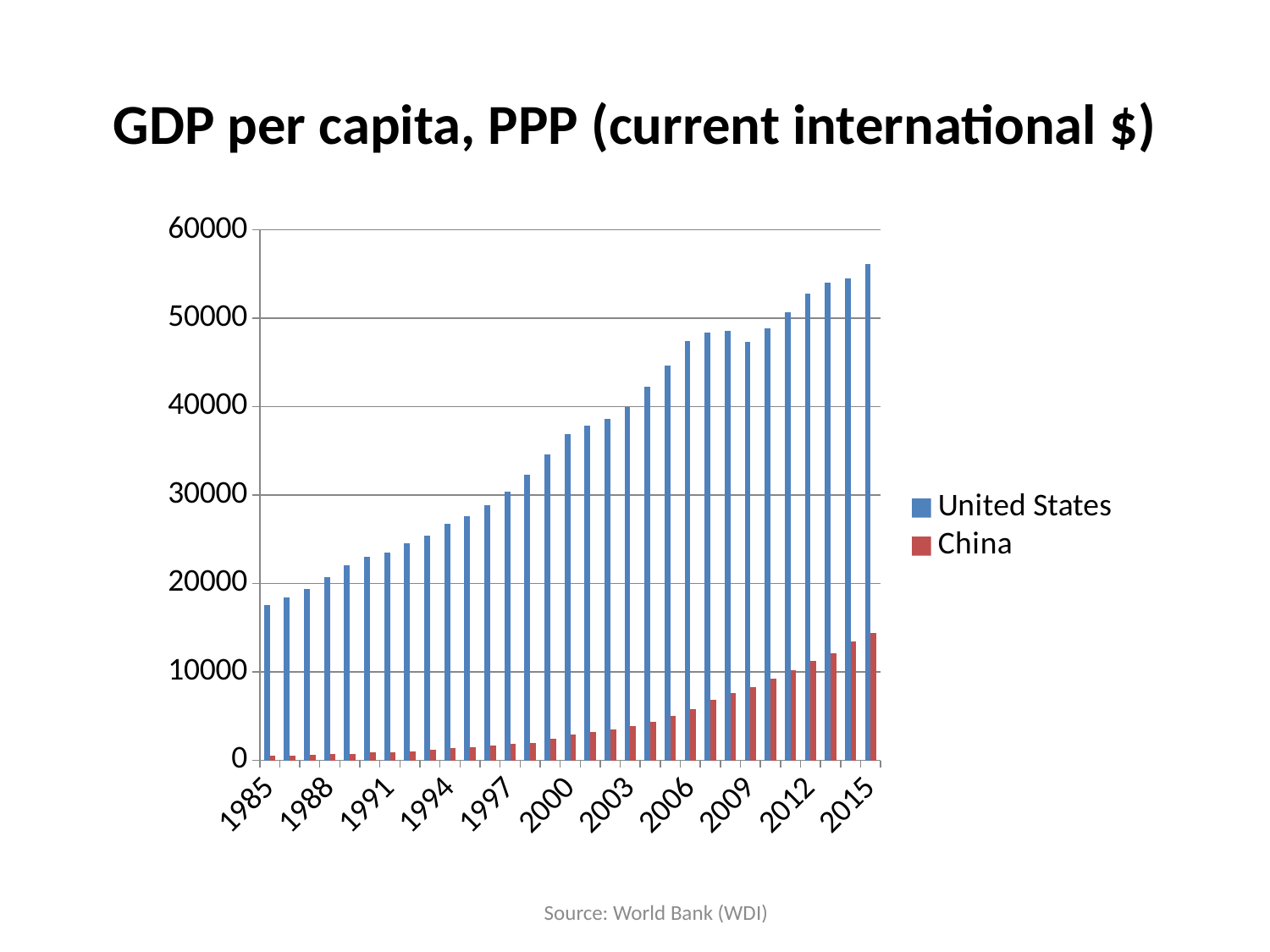
Is the value for the United States in 1985 greater or less than 20000? less In which year is the United States value lowest? 1985 Is the value for China in 2003 greater or less than 10000? less Is the value for China in 2015 greater or less than 10000? greater What is the title of the chart? GDP per capita, PPP (current international $) In which year is the United States value highest? 2015 What kind of chart is shown on the slide? bar chart In 2015, which series has the larger value, United States or China? United States How many series does the legend list? 2 Which two series are shown in the legend? United States and China